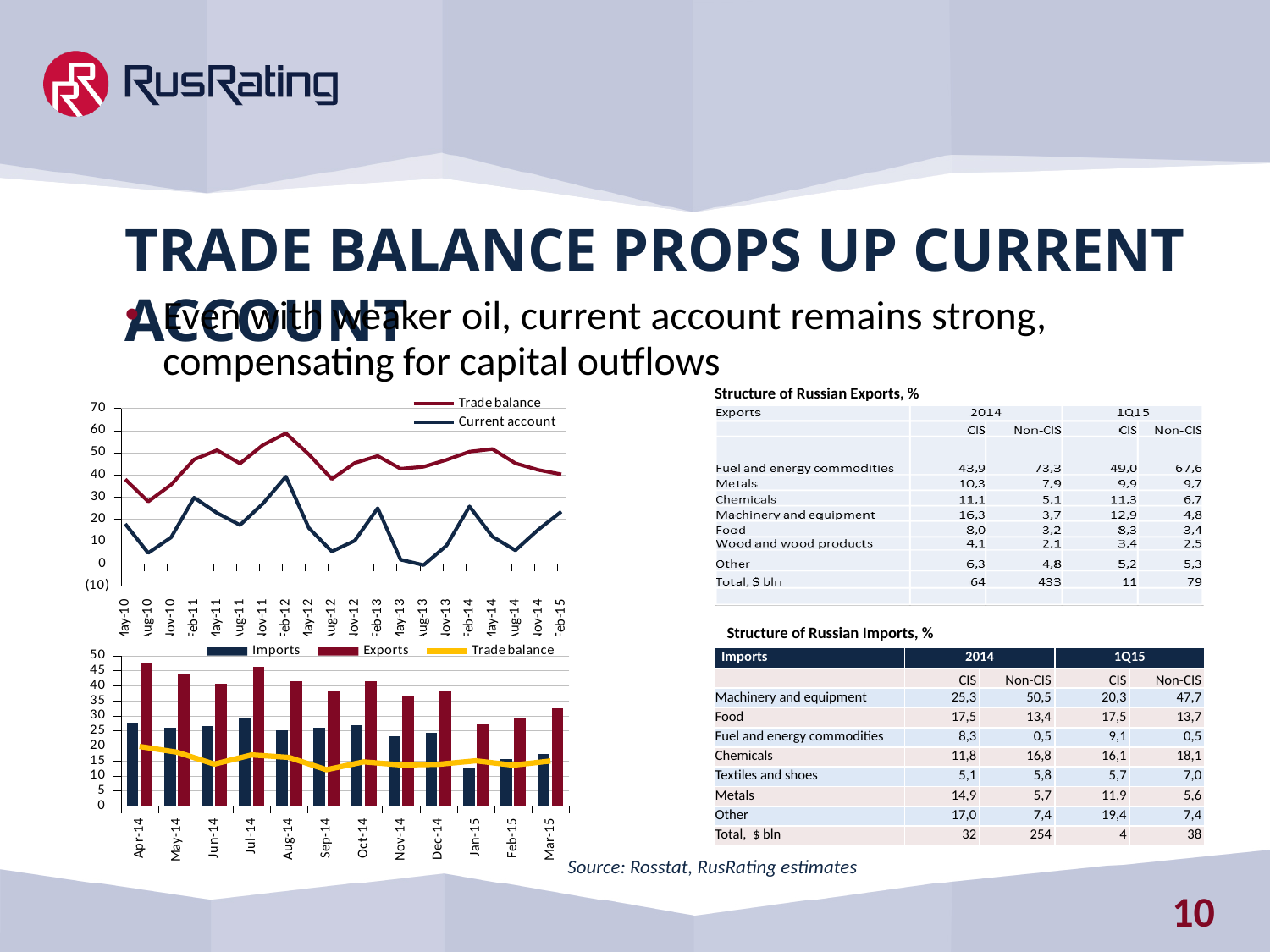
What kind of chart is the bottom chart on the slide? Combination bar and line chart In the bottom chart, which is larger for Apr-14, Imports or Exports? Exports In the bottom chart, is the Imports value for Jan-15 greater or less than 15? less How many months are shown on the x axis of the bottom chart? 12 In the bottom chart, is the Exports value for Mar-15 greater or less than 30? greater How many series does the legend of the bottom chart list? 3 How many series does the legend of the top chart list? 2 What kind of chart is the top chart on the slide? Line chart In the top chart, which series is higher at Feb-15, Trade balance or Current account? Trade balance In the bottom chart, is the Exports value for Apr-14 greater or less than 45? greater In the bottom chart, do the Exports values generally rise or fall from Apr-14 to Mar-15? Fall